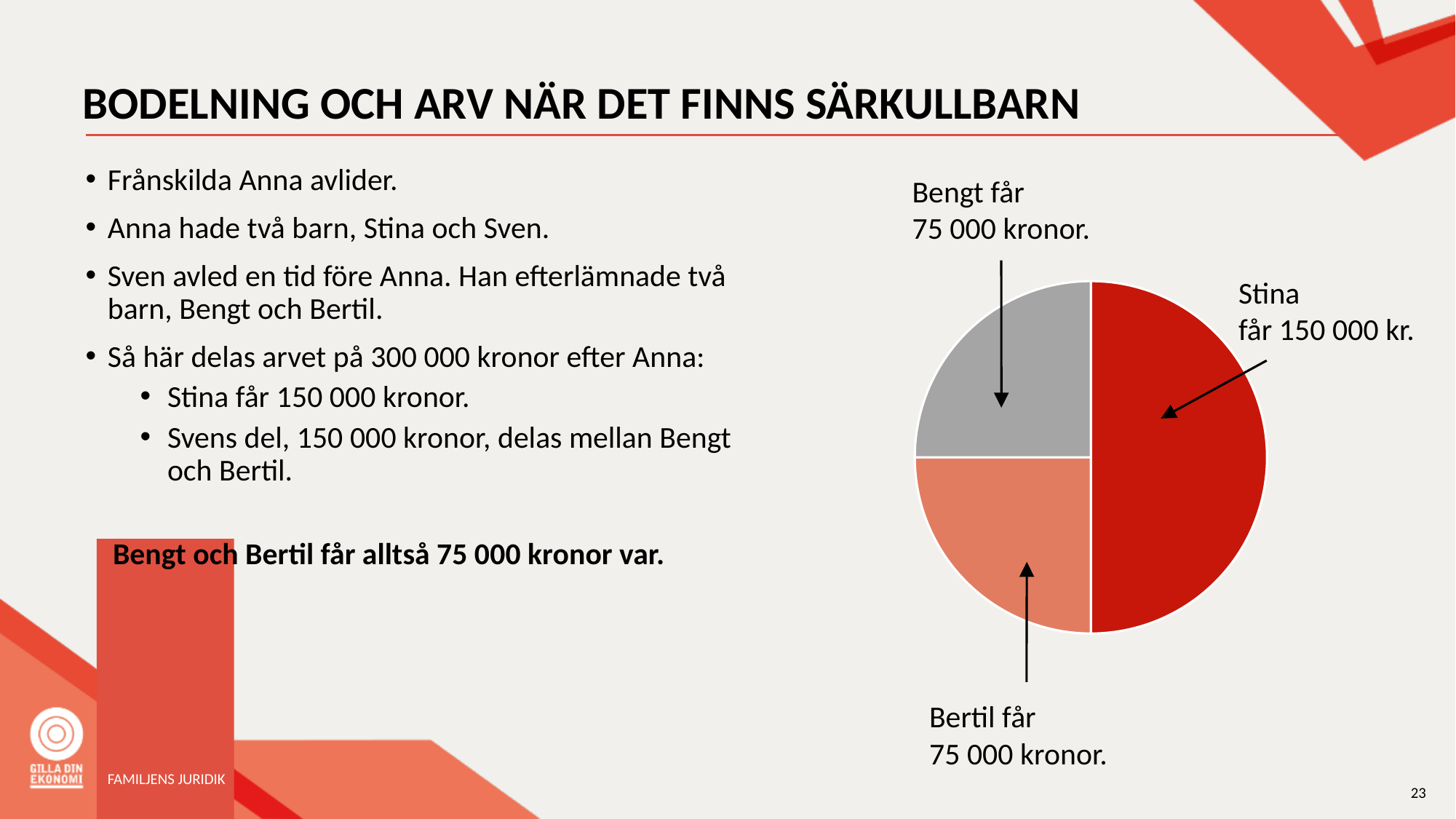
How much does Bertil receive according to the pie chart? 75 000 kronor How many slices does the pie chart have? 3 What share of the pie chart does Bengt's slice represent? 25% What kind of chart is shown on the slide? pie chart How much does Stina receive according to the pie chart? 150 000 kr What is the difference between Stina's amount and Bengt's amount in the pie chart? 75 000 kronor Which person receives the largest share of the pie chart? Stina What colour is Stina's slice in the pie chart? red What share of the pie chart does Stina's slice represent? 50% How much does Bengt receive according to the pie chart? 75 000 kronor What is the total of all slices in the pie chart? 300 000 kronor Who receives more according to the pie chart, Stina or Bertil? Stina